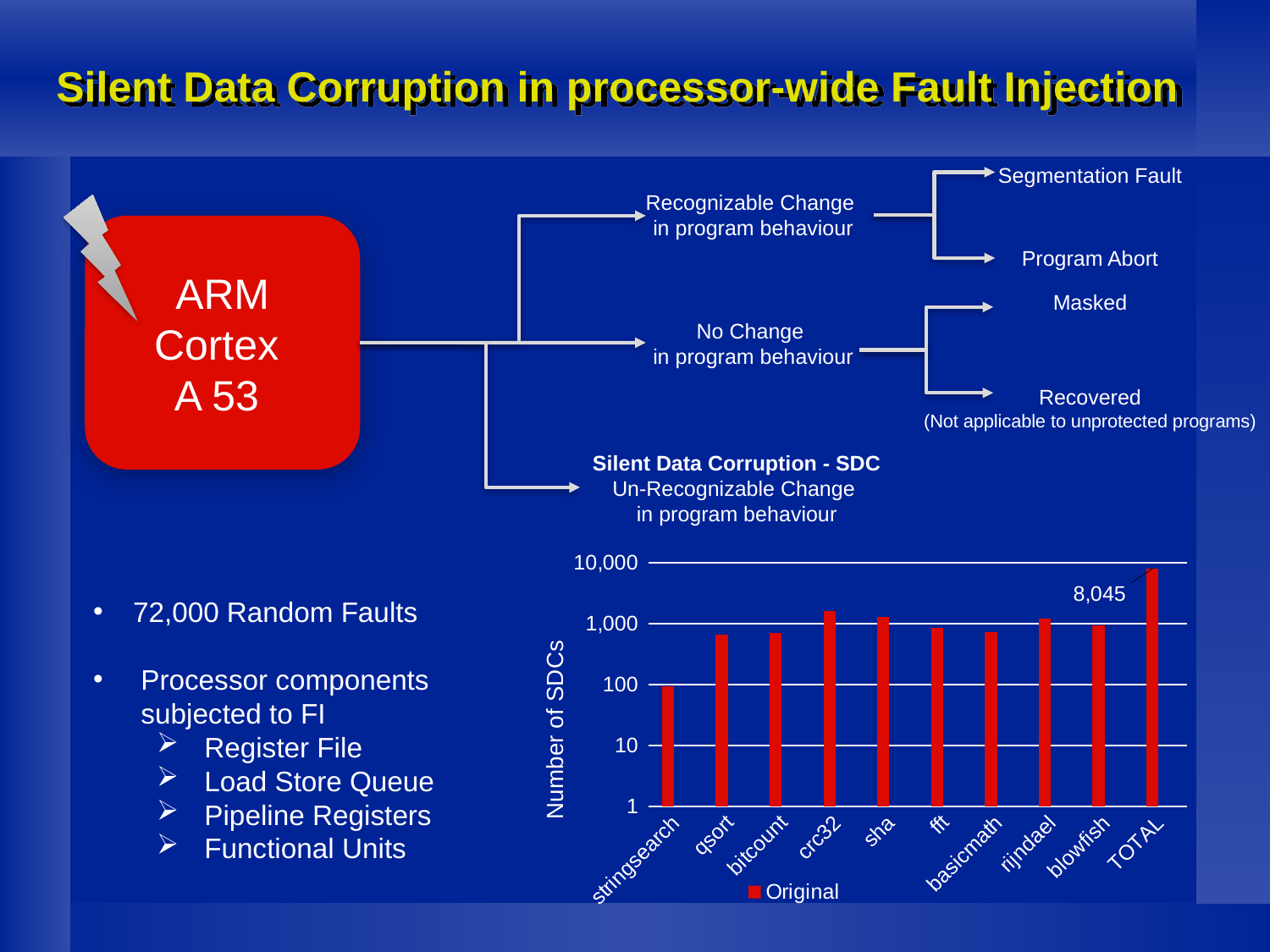
What is the value of the TOTAL bar in the Number of SDCs chart? 8,045 Is the value for TOTAL greater or less than 1,000? greater How many series does the chart legend list? 1 What kind of chart is used to show the number of SDCs? bar chart How many categories are shown on the x axis of the chart? 10 Which category has the highest number of SDCs? TOTAL Which has more SDCs, crc32 or qsort? crc32 Is the value for crc32 greater or less than 1,000? greater Which category has the lowest number of SDCs? stringsearch Which has more SDCs, stringsearch or bitcount? bitcount Is the value for qsort greater or less than 1,000? less